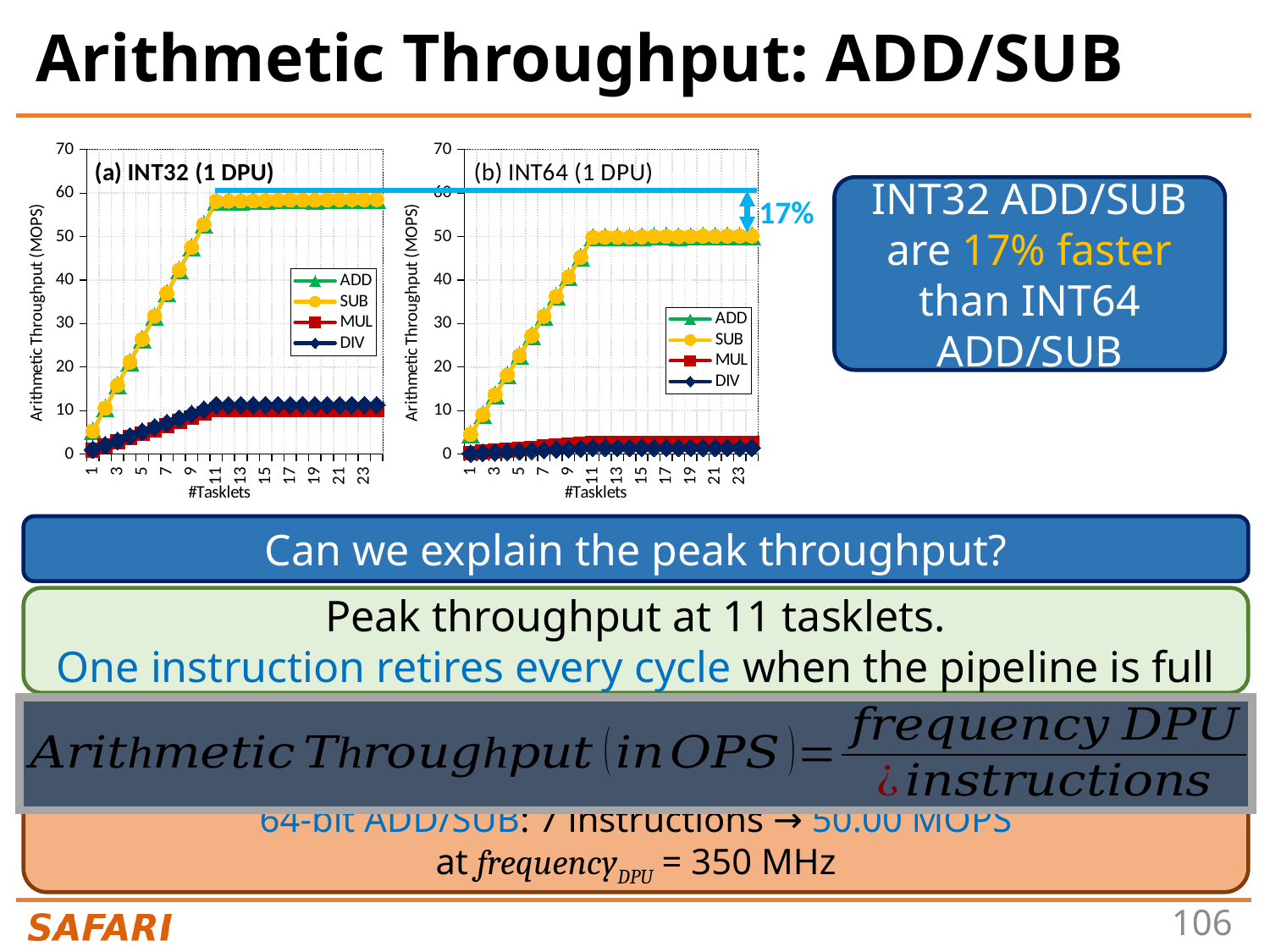
In the (a) INT32 (1 DPU) chart, which series are listed in the legend? ADD, SUB, MUL, DIV Is the peak ADD throughput in the (a) INT32 (1 DPU) chart greater or less than the peak ADD throughput in the (b) INT64 (1 DPU) chart? greater In the (a) INT32 (1 DPU) chart, is the MUL throughput at 23 tasklets greater or less than 20 MOPS? less In the (b) INT64 (1 DPU) chart, is the DIV throughput at 23 tasklets greater or less than 10 MOPS? less How many series does the legend of the (b) INT64 (1 DPU) chart list? 4 In the (a) INT32 (1 DPU) chart, is the ADD throughput at 23 tasklets greater or less than 50 MOPS? greater In the (a) INT32 (1 DPU) chart, does the ADD throughput rise or fall as the number of tasklets increases from 1 to 11? rise What is the label of the x axis on the (b) INT64 (1 DPU) chart? #Tasklets In the (a) INT32 (1 DPU) chart, which series has the lowest throughput at 23 tasklets? MUL What kind of chart is the (a) INT32 (1 DPU) chart? line chart In the (b) INT64 (1 DPU) chart, which is larger at 23 tasklets, the ADD throughput or the MUL throughput? ADD